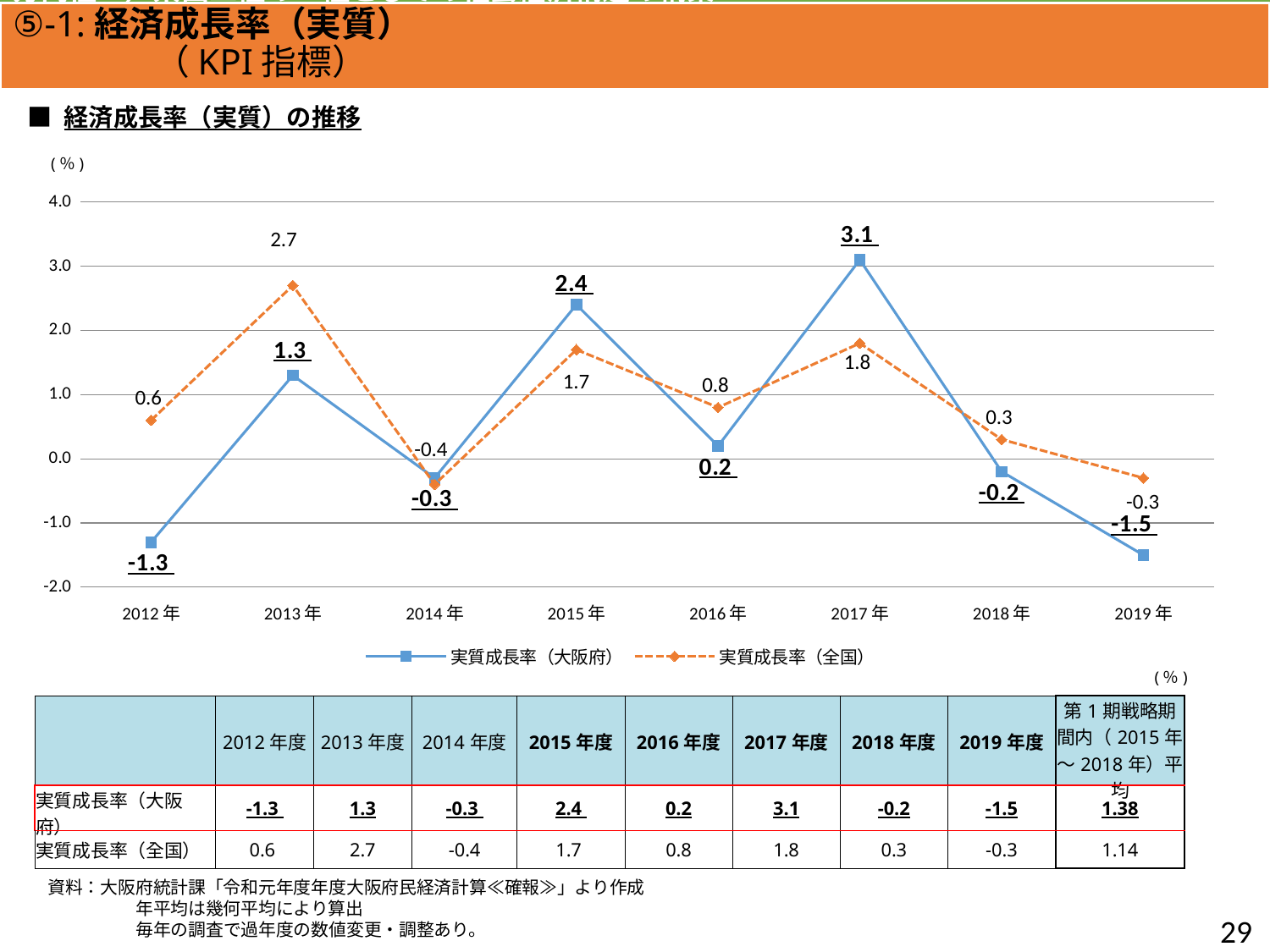
How many series does the chart legend list? 2 What is the difference between 実質成長率（全国） and 実質成長率（大阪府） in 2012年? 1.9 How many years are plotted along the x axis of the chart? 8 In which year is 実質成長率（大阪府） highest? 2017年 What unit is shown on the y axis of the chart? (%) Does 実質成長率（大阪府） rise or fall from 2017年 to 2019年? fall What is the value of 実質成長率（大阪府） in 2017年? 3.1 What is the value of 実質成長率（全国） in 2013年? 2.7 What type of chart is shown on the slide? line chart What is the value of 実質成長率（大阪府） in 2019年? -1.5 In 2016年, which series has the larger value, 実質成長率（大阪府） or 実質成長率（全国）? 実質成長率（全国） In which year is 実質成長率（全国） lowest? 2014年